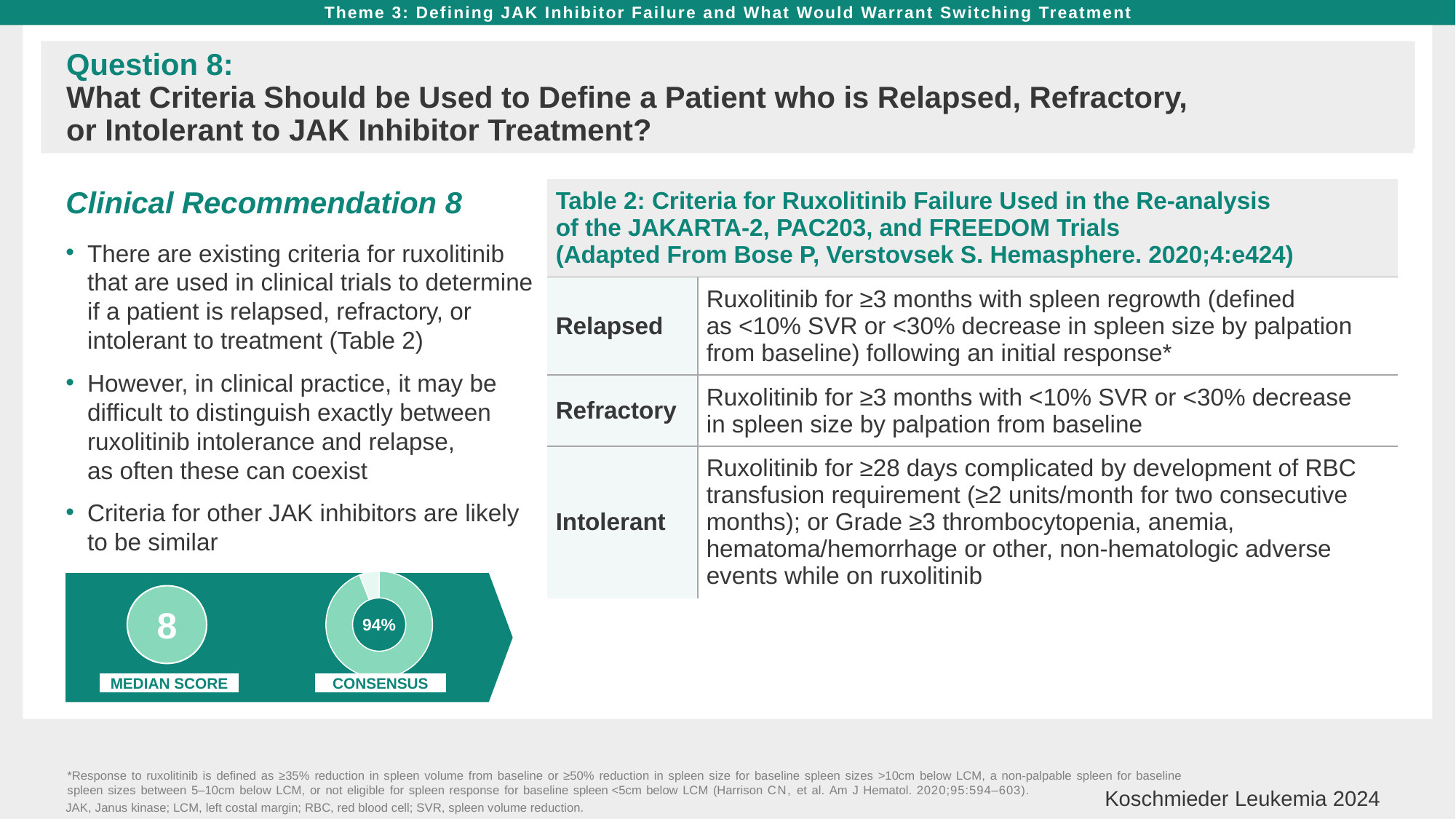
What share of the consensus donut chart is not covered by the 94% segment? 6% What median score is displayed next to the consensus donut chart? 8 What label appears beneath the donut chart? CONSENSUS Is the consensus value shown in the donut chart greater or less than 90%? greater What kind of chart is used to display the consensus value? Donut (pie) chart What percentage is shown in the consensus donut chart? 94%